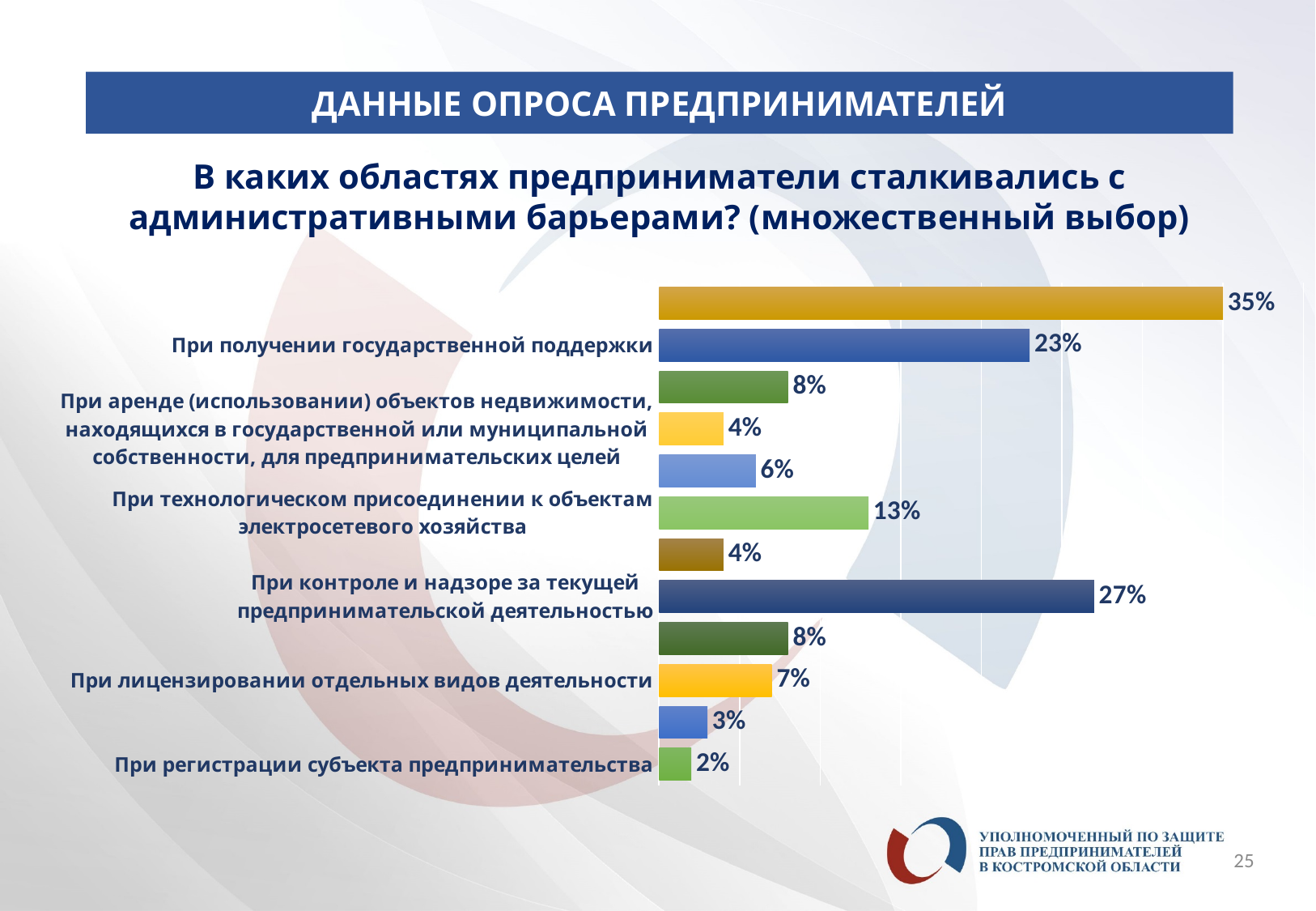
What is the title of the chart on the slide? В каких областях предприниматели сталкивались с административными барьерами? (множественный выбор) Which is larger: the value for 'При технологическом присоединении к объектам электросетевого хозяйства' or the value for 'При лицензировании отдельных видов деятельности'? При технологическом присоединении к объектам электросетевого хозяйства What is the value of the longest bar in the chart? 35% What is the value for 'При лицензировании отдельных видов деятельности'? 7% What is the value of the shortest bar in the chart? 2% What is the value for 'При получении государственной поддержки'? 23% What is the difference between the value for 'При контроле и надзоре за текущей предпринимательской деятельностью' and the value for 'При получении государственной поддержки'? 4% What is the value for 'При регистрации субъекта предпринимательства'? 2% What kind of chart is shown on the slide? bar chart What is the value for 'При технологическом присоединении к объектам электросетевого хозяйства'? 13% How many bars are plotted in the chart? 12 What is the value for 'При контроле и надзоре за текущей предпринимательской деятельностью'? 27%